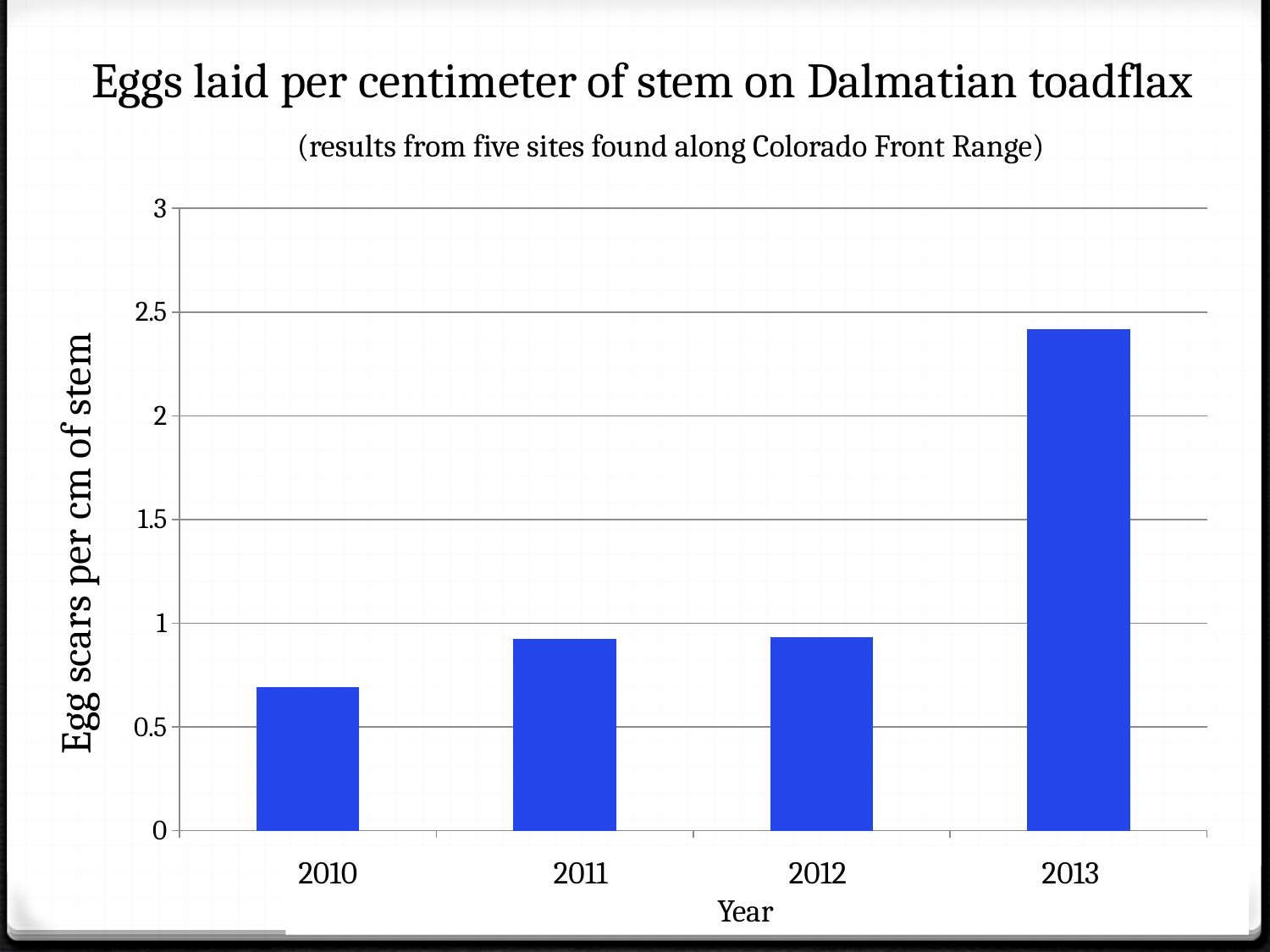
Is the value for 2013 greater or less than 2.5? less Which is larger, the value for 2010 or the value for 2013? 2013 Which year has the highest number of egg scars per cm of stem? 2013 What kind of chart is shown on the slide? bar chart What is the title of the chart? Eggs laid per centimeter of stem on Dalmatian toadflax Is the value for 2013 greater or less than 2? greater Which year has the lowest number of egg scars per cm of stem? 2010 How many years are shown on the x axis of the chart? 4 Is the value for 2011 greater or less than 0.5? greater What is the label on the y axis of the chart? Egg scars per cm of stem Do the values generally rise or fall from 2010 to 2013? rise